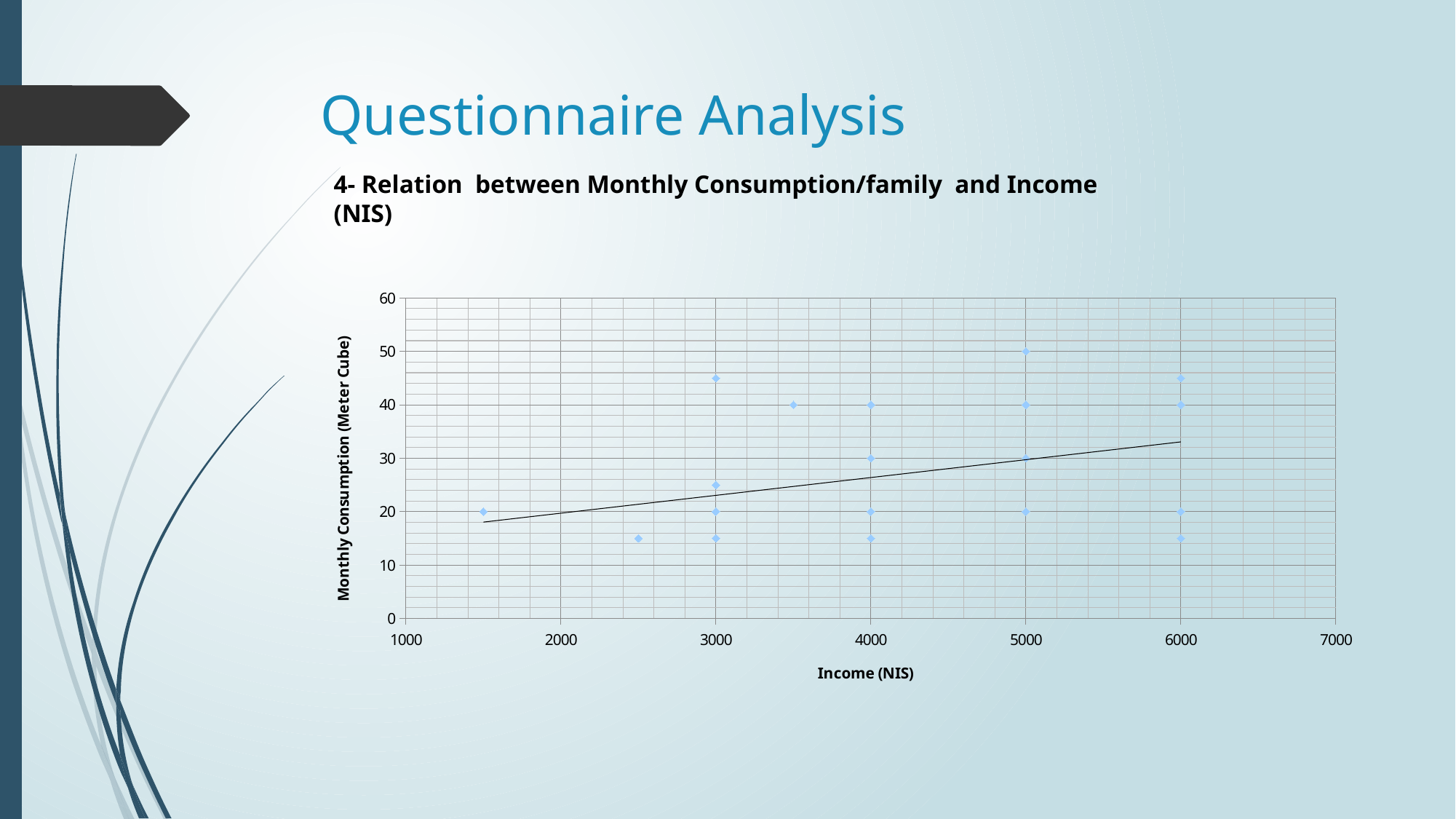
What is the monthly consumption value of the point plotted at an income of 1500? 20 Which is larger: the highest point at income 5000 or the highest point at income 6000? the highest point at income 5000 Does the trend line rise or fall as income increases? rises What is the highest monthly consumption value plotted on the chart? 50 What is the monthly consumption value of the point plotted at an income of 3500? 40 Is the monthly consumption value of the point at income 1500 greater or less than 30? less What is the title of the x axis of the chart? Income (NIS) Is the value of the trend line at income 6000 greater or less than 30? greater At which income level is the highest monthly consumption point plotted? 5000 What is the title of the y axis of the chart? Monthly Consumption (Meter Cube) What type of chart is shown on the slide? scatter chart